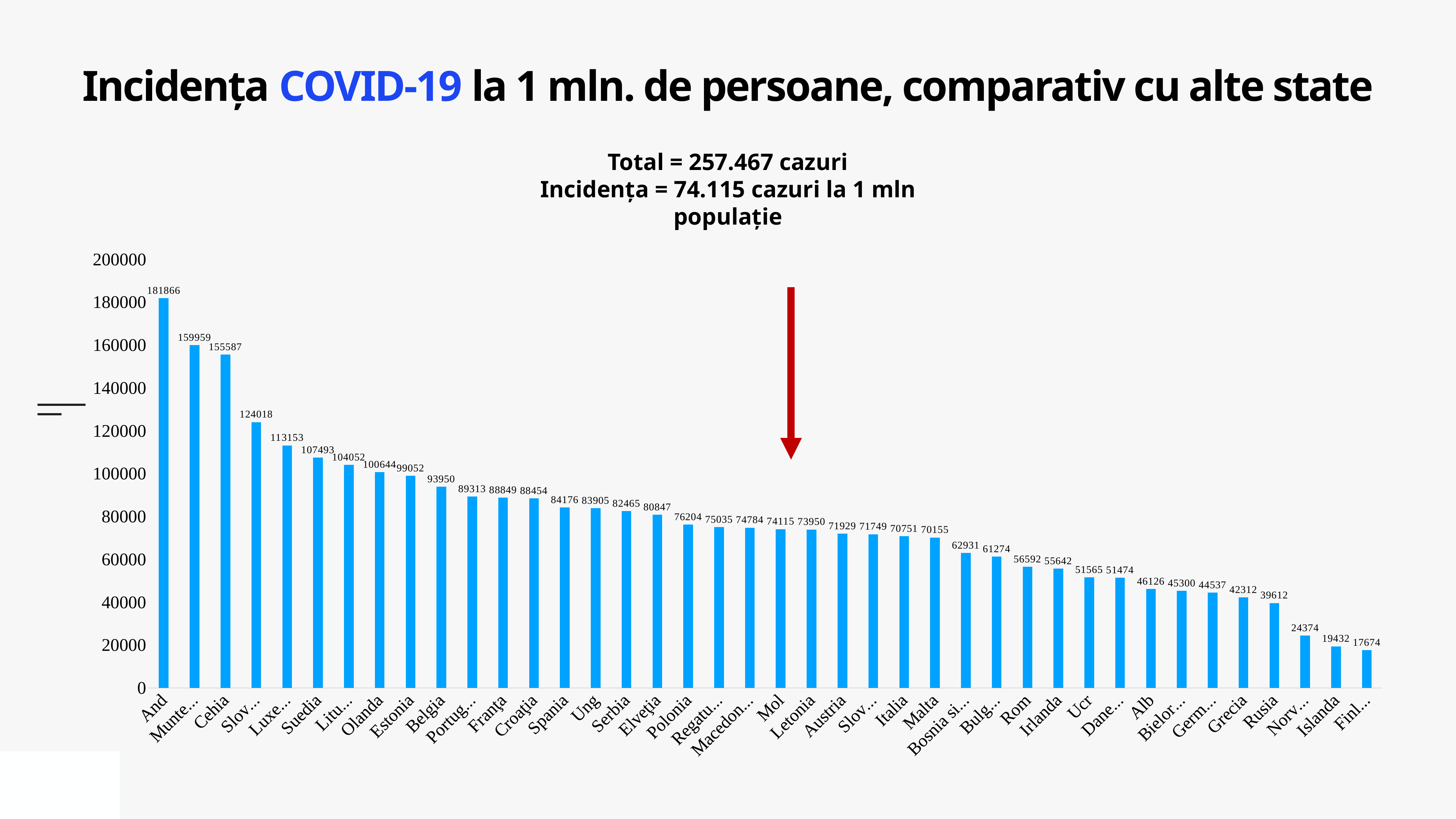
Do the values rise or fall from left to right along the x axis? fall How many bars are shown in the chart? 40 Which category has the highest value? And What kind of chart is shown on the slide? bar chart Is the value for Malta greater or less than 60000? greater What is the difference between the values for Cehia and Suedia? 48094 What is the title of the slide? Incidența COVID-19 la 1 mln. de persoane, comparativ cu alte state What is the value for Cehia? 155587 What is the value for Irlanda? 55642 Which is larger, the value for Polonia or the value for Italia? Polonia What is the value for Mol? 74115 What is the difference between the values for Estonia and Letonia? 25102